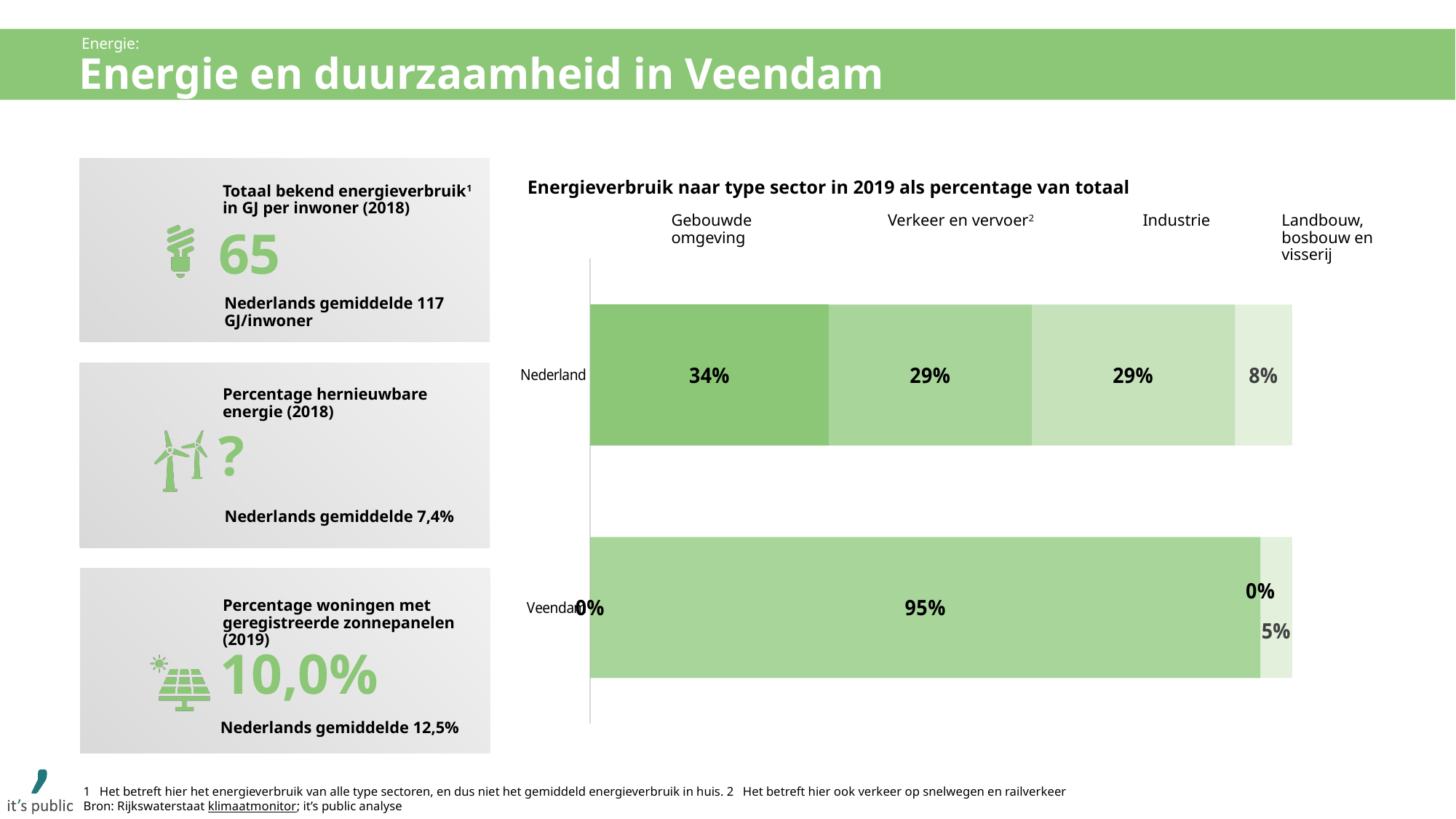
What is the value for Industrie for Nederland? 29% Which is larger: the Gebouwde omgeving share for Nederland or the Landbouw, bosbouw en visserij share for Nederland? Gebouwde omgeving What kind of chart is shown under the title 'Energieverbruik naar type sector in 2019 als percentage van totaal'? Stacked bar chart Which sector has the smallest share for Nederland? Landbouw, bosbouw en visserij What is the difference between the Verkeer en vervoer share for Veendam and for Nederland? 66% What is the value for Gebouwde omgeving for Nederland? 34% Which sector has the largest share for Veendam? Verkeer en vervoer What is the value for Gebouwde omgeving for Veendam? 0% How many regions (bars) are shown in the chart? 2 What is the value for Landbouw, bosbouw en visserij for Veendam? 5% How many sector series are shown in the chart? 4 What is the value for Verkeer en vervoer for Veendam? 95%